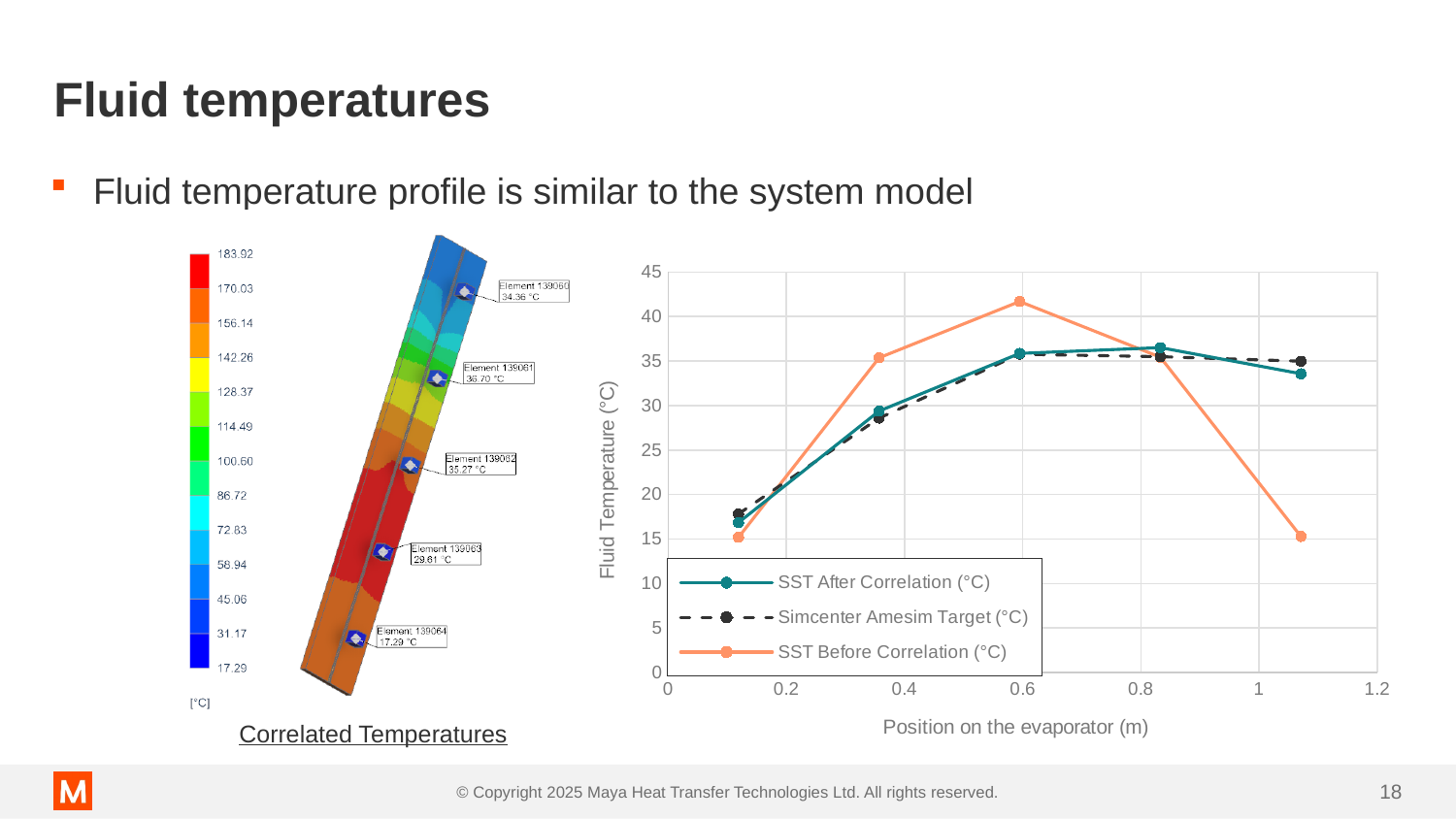
Is the value of SST After Correlation (°C) at about 0.36 m greater or less than 25? greater Does the SST Before Correlation (°C) series rise or fall between 0.6 m and the last plotted position? fall What kind of chart is shown on the right of the slide? line chart How many data points are plotted for the SST After Correlation (°C) series? 5 Which series reaches the highest fluid temperature anywhere on the line chart? SST Before Correlation (°C) At the last plotted position (around 1.07 m), which is larger: SST After Correlation (°C) or SST Before Correlation (°C)? SST After Correlation (°C) At about 0.6 m, which is larger: SST Before Correlation (°C) or SST After Correlation (°C)? SST Before Correlation (°C) How many series does the legend of the line chart list? 3 What is the title of the x axis of the line chart? Position on the evaporator (m) Is the peak value of the SST Before Correlation (°C) series, at about 0.6 m, greater or less than 40? greater Is the value of SST Before Correlation (°C) at the last position (around 1.07 m) greater or less than 20? less Which series has the lowest value at the last plotted position (around 1.07 m)? SST Before Correlation (°C)